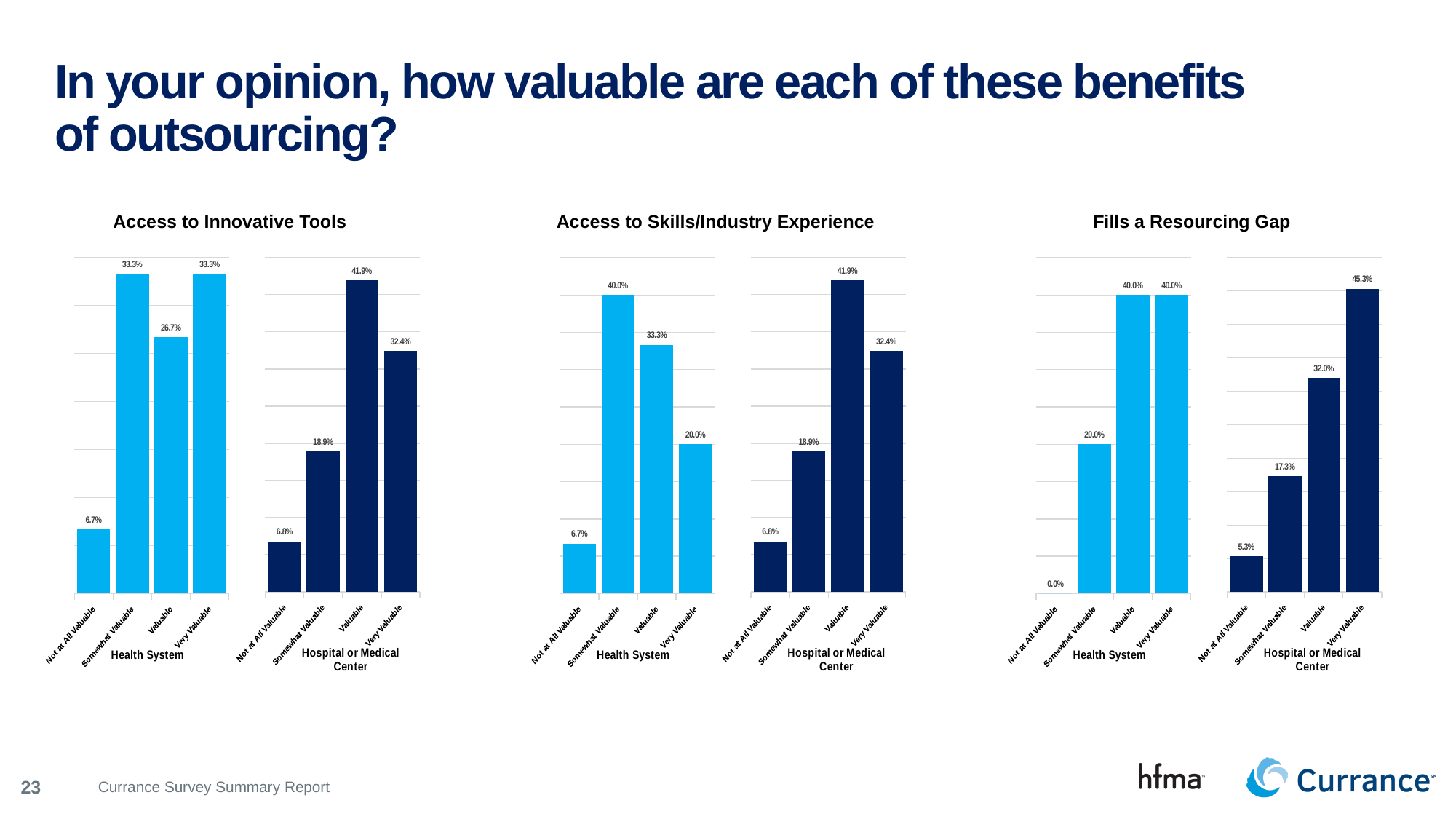
In the 'Access to Innovative Tools' chart, which is larger for Hospital or Medical Center: Somewhat Valuable or Very Valuable? Very Valuable In the 'Fills a Resourcing Gap' chart, what is the Health System value for Not at All Valuable? 0.0% In the 'Access to Innovative Tools' chart, what is the Health System value for Valuable? 26.7% How many categories are shown on the x axis of the Health System group in the 'Fills a Resourcing Gap' chart? 4 In the 'Fills a Resourcing Gap' chart, what is the Hospital or Medical Center value for Somewhat Valuable? 17.3% In the 'Access to Skills/Industry Experience' chart, what is the Health System value for Very Valuable? 20.0% In the 'Access to Skills/Industry Experience' chart, which category has the highest Health System value? Somewhat Valuable In the 'Fills a Resourcing Gap' chart, which category has the highest Hospital or Medical Center value? Very Valuable What type of chart is used for 'Access to Innovative Tools'? Bar chart In the 'Fills a Resourcing Gap' chart, what is the difference between the Hospital or Medical Center values for Very Valuable and Valuable? 13.3% In the 'Access to Innovative Tools' chart, what is the Hospital or Medical Center value for Valuable? 41.9% In the 'Access to Skills/Industry Experience' chart, which category has the lowest Hospital or Medical Center value? Not at All Valuable